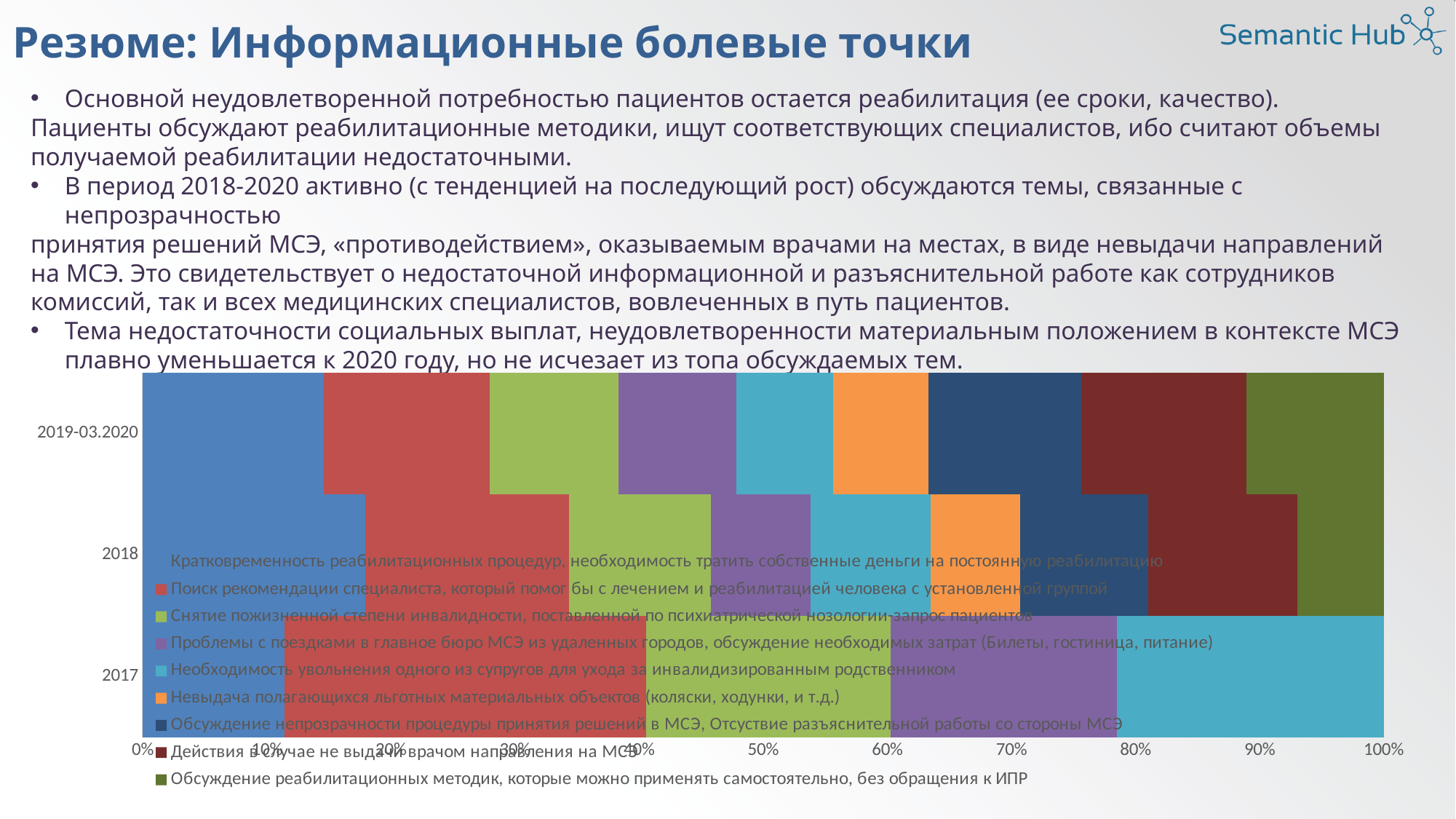
Is the share of the segment 'Поиск рекомендации специалиста...' in the 2017 bar greater or less than 20%? greater How many coloured segments make up the bar for 2017? 5 What kind of chart is shown on the slide? Stacked horizontal bar chart Which period has the larger share for the segment 'Кратковременность реабилитационных процедур...': 2017 or 2018? 2018 Which period is shown at the top of the chart? 2019-03.2020 How many series does the chart legend list? 9 Which period has the larger share for the segment 'Поиск рекомендации специалиста...': 2017 or 2018? 2017 In which period does the segment 'Необходимость увольнения одного из супругов...' have its largest share? 2017 What is the highest value shown on the horizontal axis of the chart? 100% Is the share of the segment 'Кратковременность реабилитационных процедур...' in the 2018 bar greater or less than 10%? greater How many categories (periods) are shown on the vertical axis of the chart? 3 Is the share of the segment 'Кратковременность реабилитационных процедур...' in the 2017 bar greater or less than 20%? less